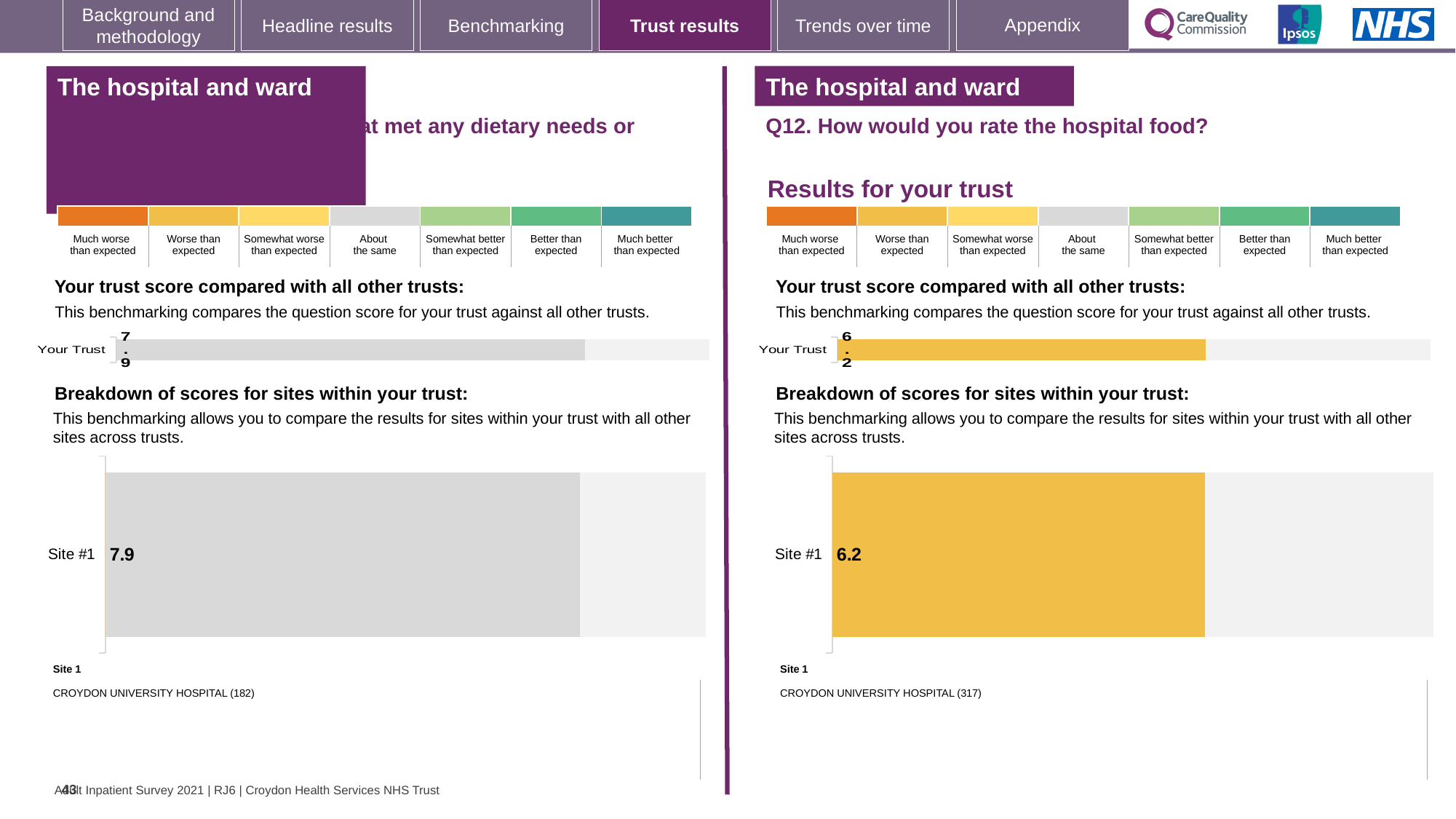
What colour is the Site #1 bar on the left-hand breakdown chart? Grey How many sites are shown in the left-hand site breakdown chart? 1 What is the difference between the Site #1 score on the left-hand breakdown chart and the Site #1 score on the right-hand Q12 breakdown chart? 1.7 Which is larger: the Site #1 score on the left-hand breakdown chart or the Site #1 score on the right-hand Q12 breakdown chart? Left-hand chart (7.9) On the right-hand chart for Q12 (hospital food), what is the score shown for Your Trust? 6.2 How many sites are shown in the right-hand Q12 site breakdown chart? 1 What type of chart is used to show the Site #1 score on the right-hand Q12 breakdown? Bar chart On the right-hand site breakdown chart for Q12, what is the score for Site #1? 6.2 On the left-hand site breakdown chart, what is the score for Site #1? 7.9 On the left-hand chart, what is the score shown for Your Trust? 7.9 What colour is the Site #1 bar on the right-hand Q12 breakdown chart? Yellow